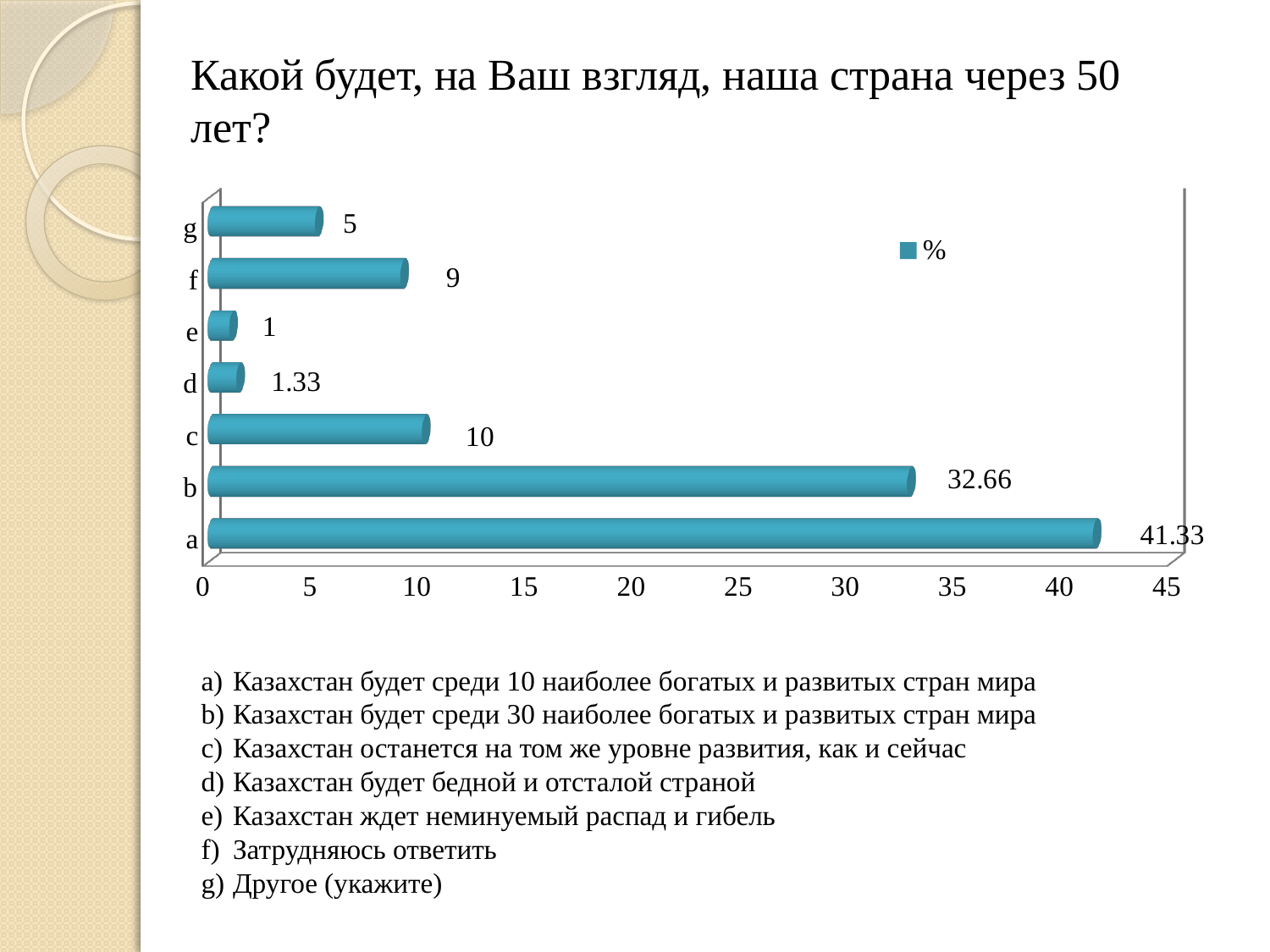
What is the value for category d? 1.33 What is the value for category b? 32.66 Is the value for b greater or less than 30? greater What kind of chart is shown on the slide? bar chart What is the value for category a? 41.33 What is the difference between the values for a and b? 8.67 What is the value for category f? 9 Which is larger, the value for c or the value for f? c How many series does the legend list? 1 Which category has the highest value? a How many categories are shown in the chart? 7 Which category has the lowest value? e